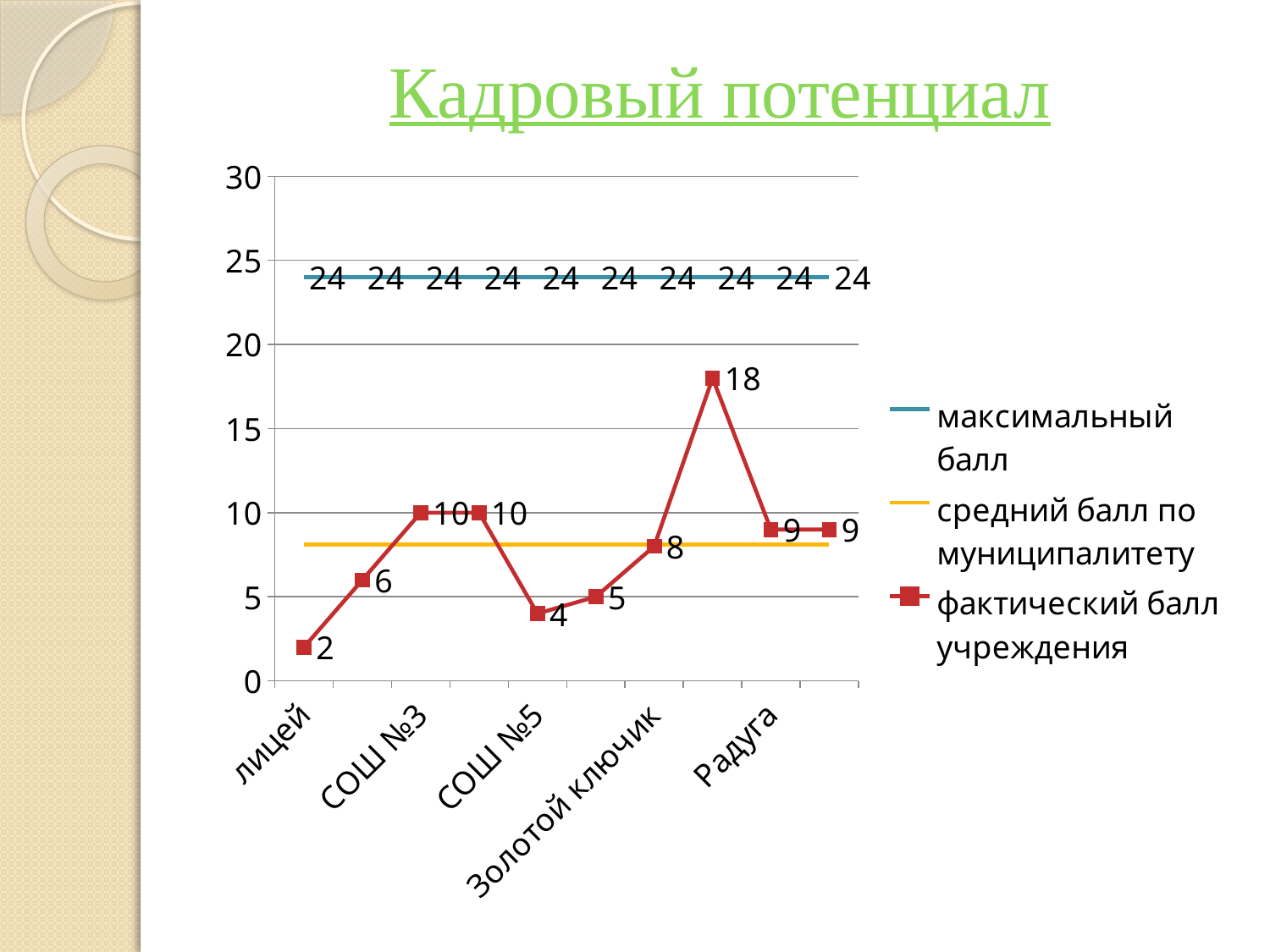
What is the фактический балл учреждения value for Радуга? 9 What is the фактический балл учреждения value for СОШ №3? 10 What is the фактический балл учреждения value for лицей? 2 What is the highest фактический балл учреждения value plotted on the chart? 18 What is the фактический балл учреждения value for СОШ №5? 4 How many series does the legend list? 3 What is the максимальный балл value shown for each institution? 24 What is the фактический балл учреждения value for Золотой ключик? 8 Which has a higher фактический балл учреждения, СОШ №3 or СОШ №5? СОШ №3 Is the средний балл по муниципалитету line greater or less than 10? less What is the difference between the фактический балл учреждения for Золотой ключик and for лицей? 6 Which labelled institution has the lowest фактический балл учреждения? лицей